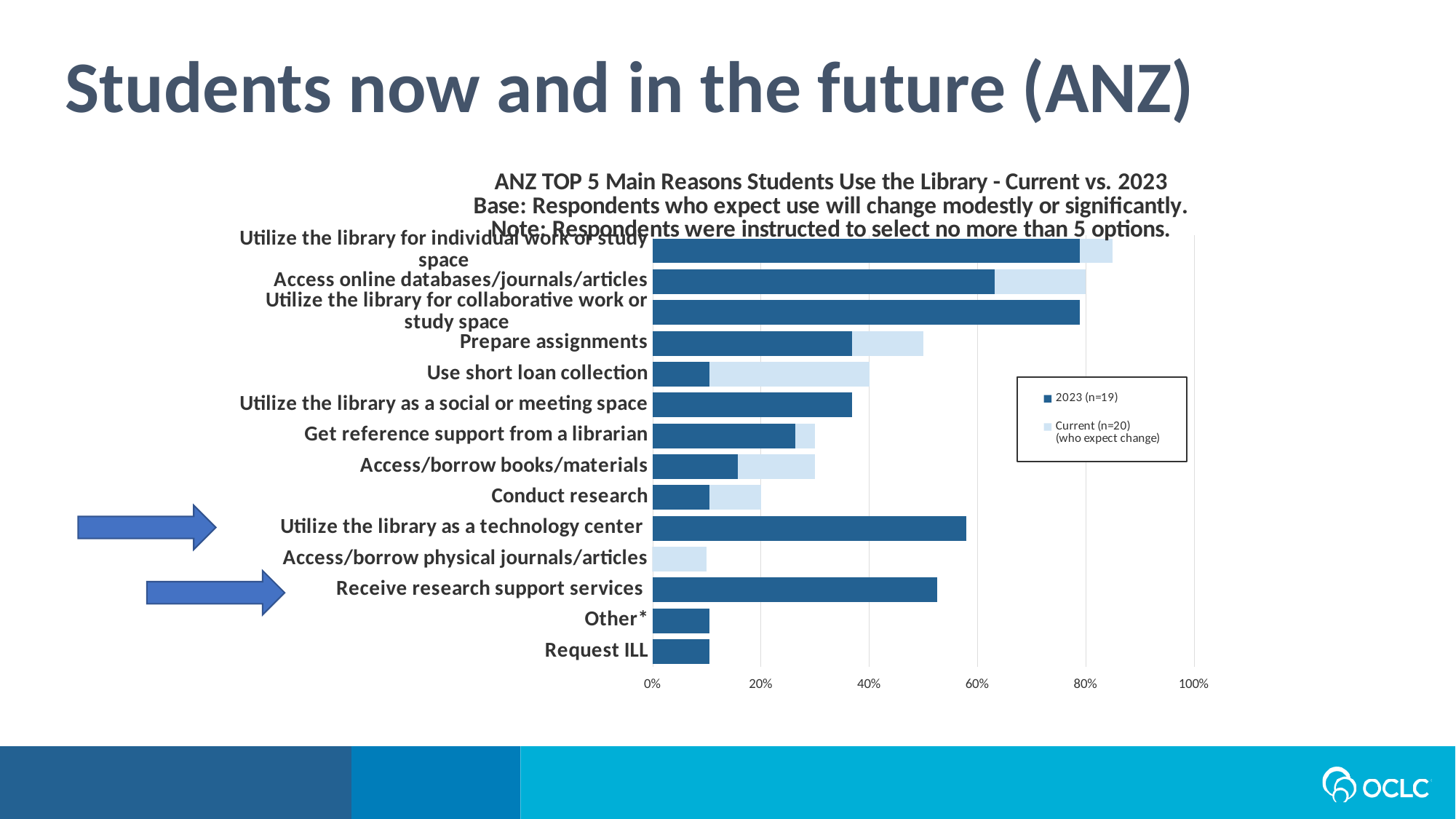
Which has the larger 2023 value: 'Utilize the library as a technology center' or 'Utilize the library as a social or meeting space'? Utilize the library as a technology center Is the 2023 value for 'Utilize the library as a technology center' greater or less than 40%? greater Which has the larger 2023 value: 'Access online databases/journals/articles' or 'Prepare assignments'? Access online databases/journals/articles Is the 2023 value for 'Receive research support services' greater or less than 40%? greater Is the 2023 value for 'Request ILL' greater or less than 20%? less How many categories (reasons) are plotted on the chart? 14 How many series does the legend list? 2 What is the sample size (n) shown in the legend for the 2023 series? n=19 What is the highest percentage tick shown on the horizontal axis? 100% What kind of chart is shown on the slide? bar chart